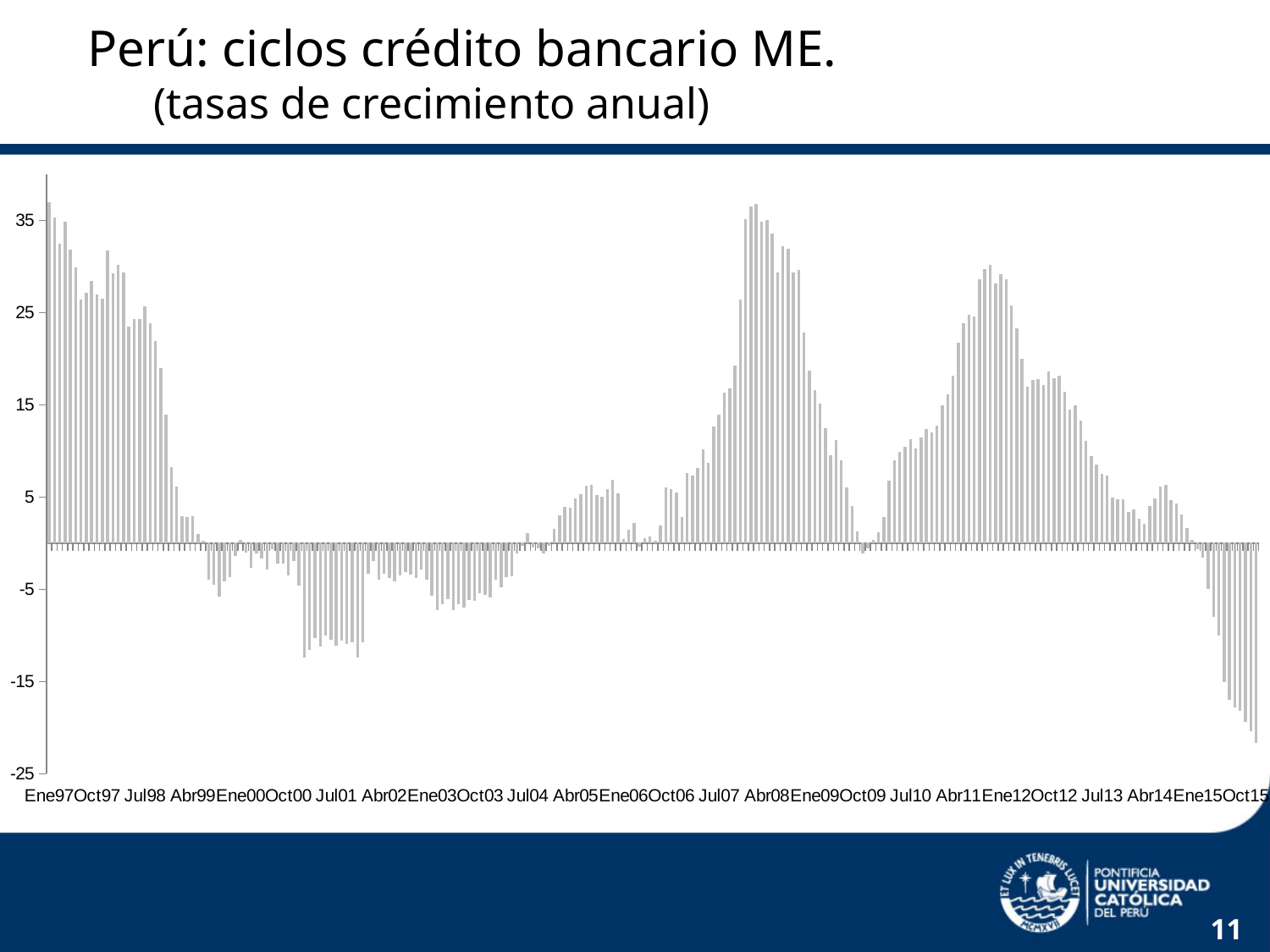
Is the value for Jul07 greater or less than 5? greater What is the title of the chart on the slide? Perú: ciclos crédito bancario ME. (tasas de crecimiento anual) Is the value for Oct15 greater or less than -15? less Which is larger, the value for Abr08 or the value for Jul07? Abr08 What is the highest value shown on the vertical axis of the chart? 35 What kind of chart is shown on the slide? bar chart Is the value for Jul01 greater or less than -5? less Do the values rise or fall between Abr08 and Ene09? fall Which is lower, the value for Jul01 or the value for Oct15? Oct15